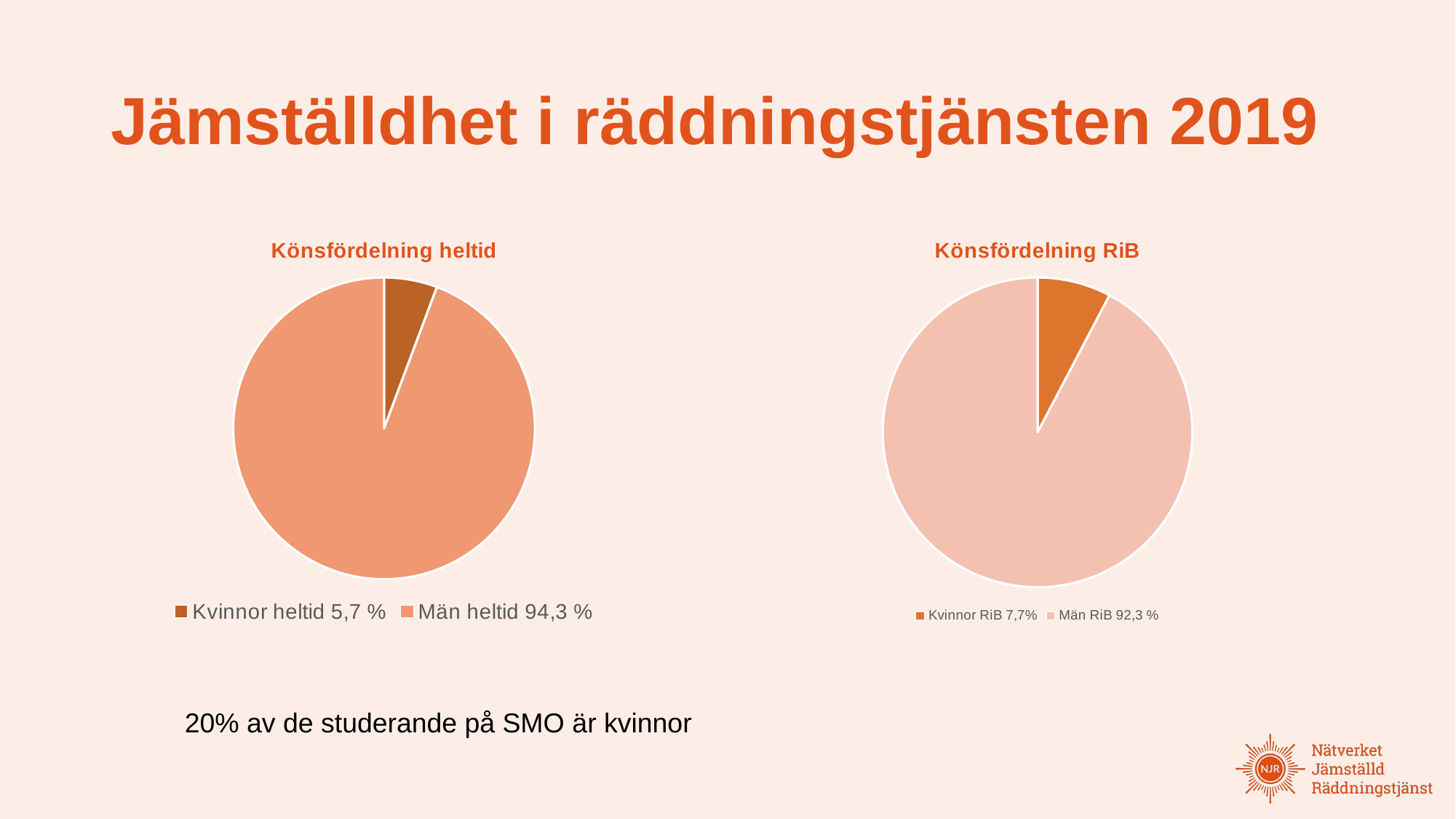
How many categories does the 'Könsfördelning RiB' chart show? 2 Which is larger: 'Kvinnor heltid' in the left chart or 'Kvinnor RiB' in the right chart? Kvinnor RiB In the 'Könsfördelning RiB' chart, which category is the smallest? Kvinnor RiB In the 'Könsfördelning heltid' chart, which category is the largest? Män heltid In the 'Könsfördelning heltid' chart, what is the difference between 'Män heltid' and 'Kvinnor heltid'? 88,6 % In the 'Könsfördelning RiB' chart, what is the difference between 'Män RiB' and 'Kvinnor RiB'? 84,6 % In the 'Könsfördelning RiB' chart, what share of the pie is 'Män RiB'? 92,3 % What kind of chart is 'Könsfördelning heltid'? Pie chart In the 'Könsfördelning RiB' chart, what is the value for 'Kvinnor RiB'? 7,7% In the 'Könsfördelning heltid' chart, what is the value for 'Män heltid'? 94,3 % What is the title of the chart on the right side of the slide? Könsfördelning RiB In the 'Könsfördelning heltid' chart, what share of the pie is 'Kvinnor heltid'? 5,7 %